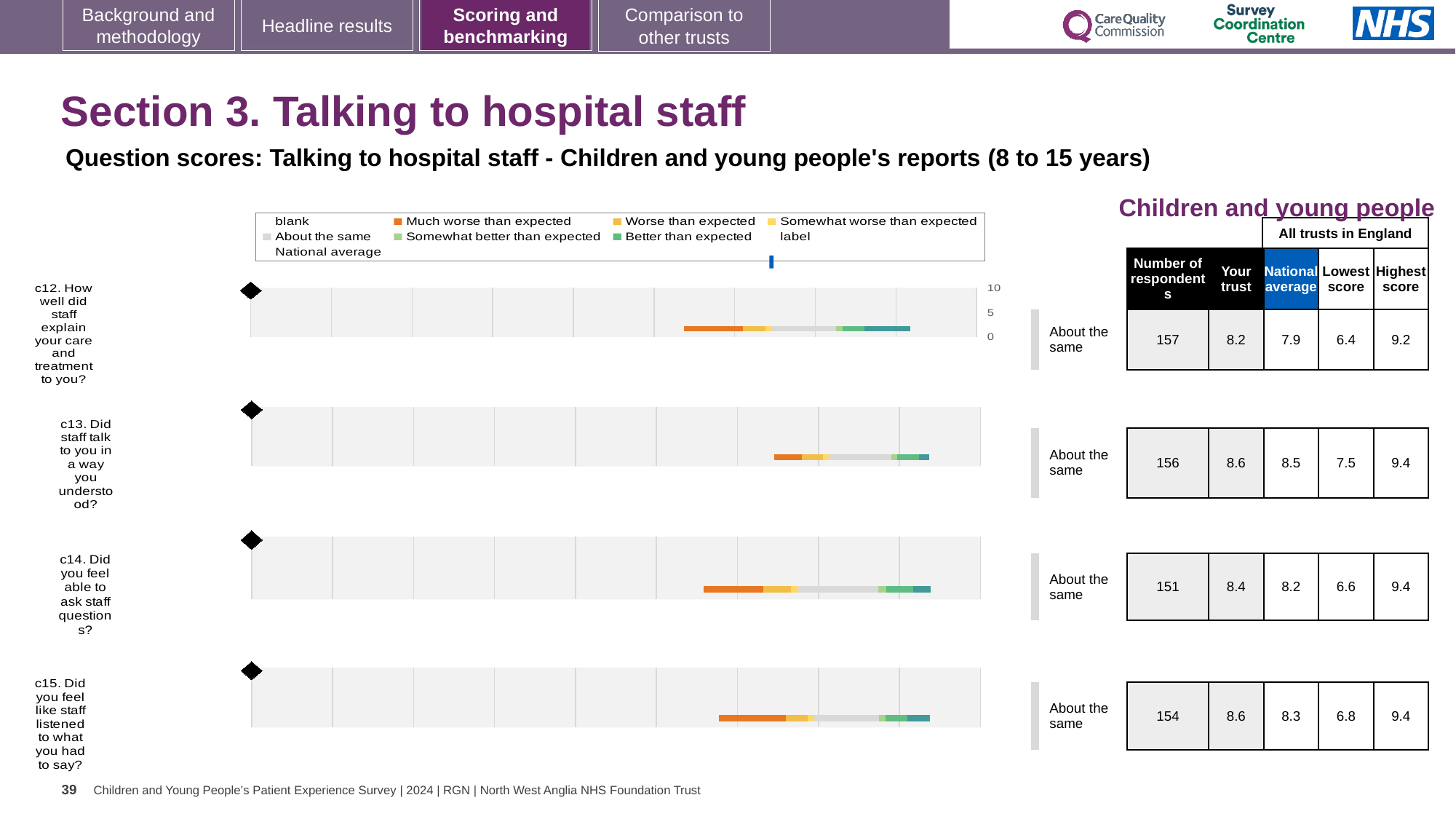
For c13 (Did staff talk to you in a way you understood?), what is the 'Your trust' score? 8.6 For c12 (How well did staff explain your care and treatment to you?), what is the number of respondents? 157 What benchmark label is shown next to the c12 chart? About the same For c14 (Did you feel able to ask staff questions?), what is the difference between the 'Your trust' score and the national average? 0.2 What colour does the legend use for 'Much worse than expected'? orange For c15 (Did you feel like staff listened to what you had to say?), which is larger: the 'Your trust' score or the national average? Your trust Which question has the lowest 'Lowest score' value? c12 Which question has the lowest 'Your trust' score? c12 What is the highest axis tick shown on the c12 chart? 10 For c14, what is the lowest score among all trusts in England? 6.6 How many question charts (c12 to c15) are shown on the slide? 4 What kind of chart is used to show the benchmark results for questions c12 to c15? bar chart